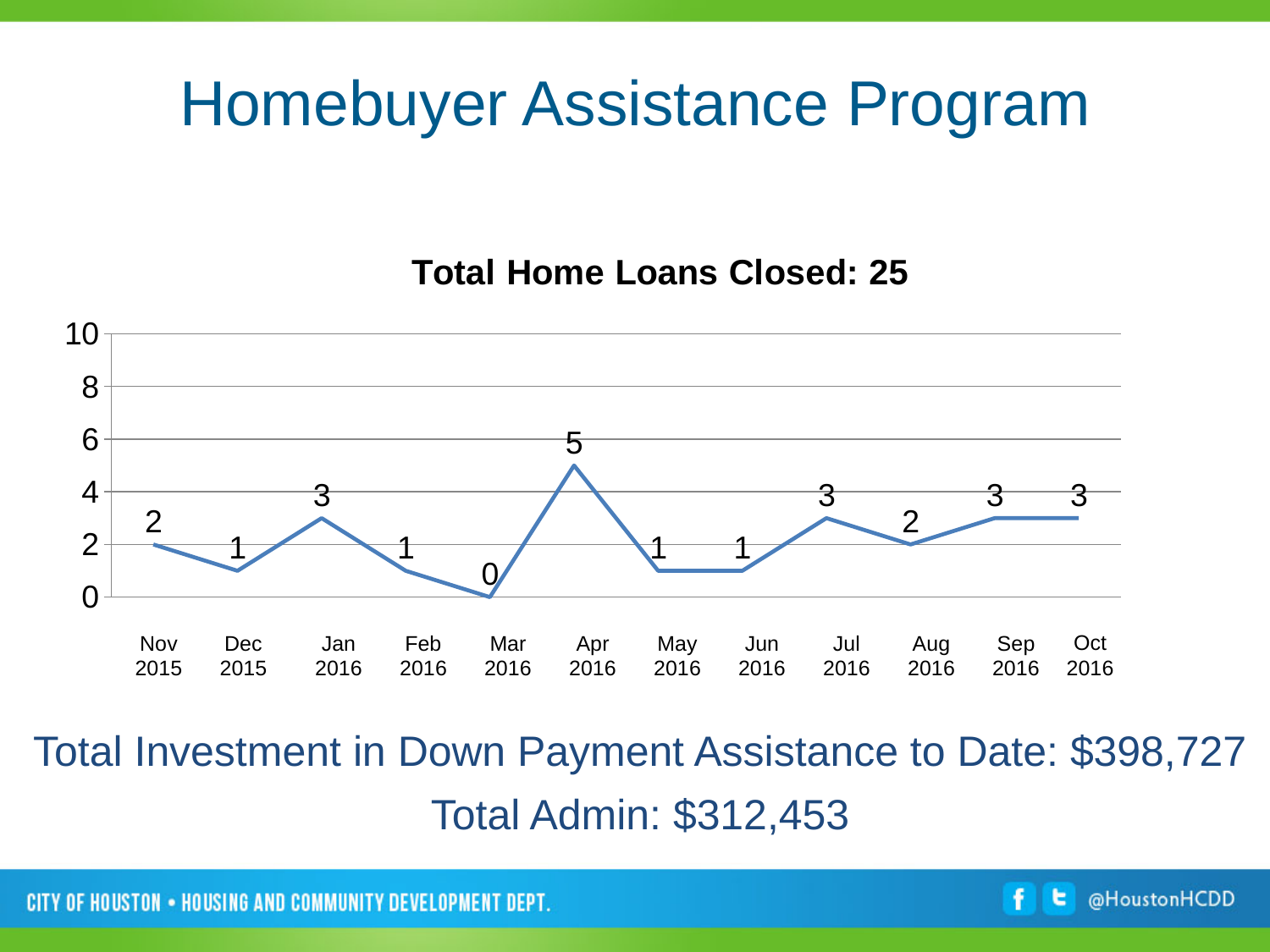
Which month has the lowest value? Mar 2016 What is the value for Mar 2016? 0 What is the title of the chart? Total Home Loans Closed: 25 Which is larger, the value for Jan 2016 or the value for Feb 2016? Jan 2016 How many months are plotted on the chart? 12 Do the values rise or fall from Jul 2016 to Aug 2016? fall What is the value for Nov 2015? 2 What kind of chart is shown on the slide? line chart What is the value for Apr 2016? 5 What is the value for Aug 2016? 2 Which month has the highest value? Apr 2016 What is the difference between the values for Apr 2016 and Aug 2016? 3